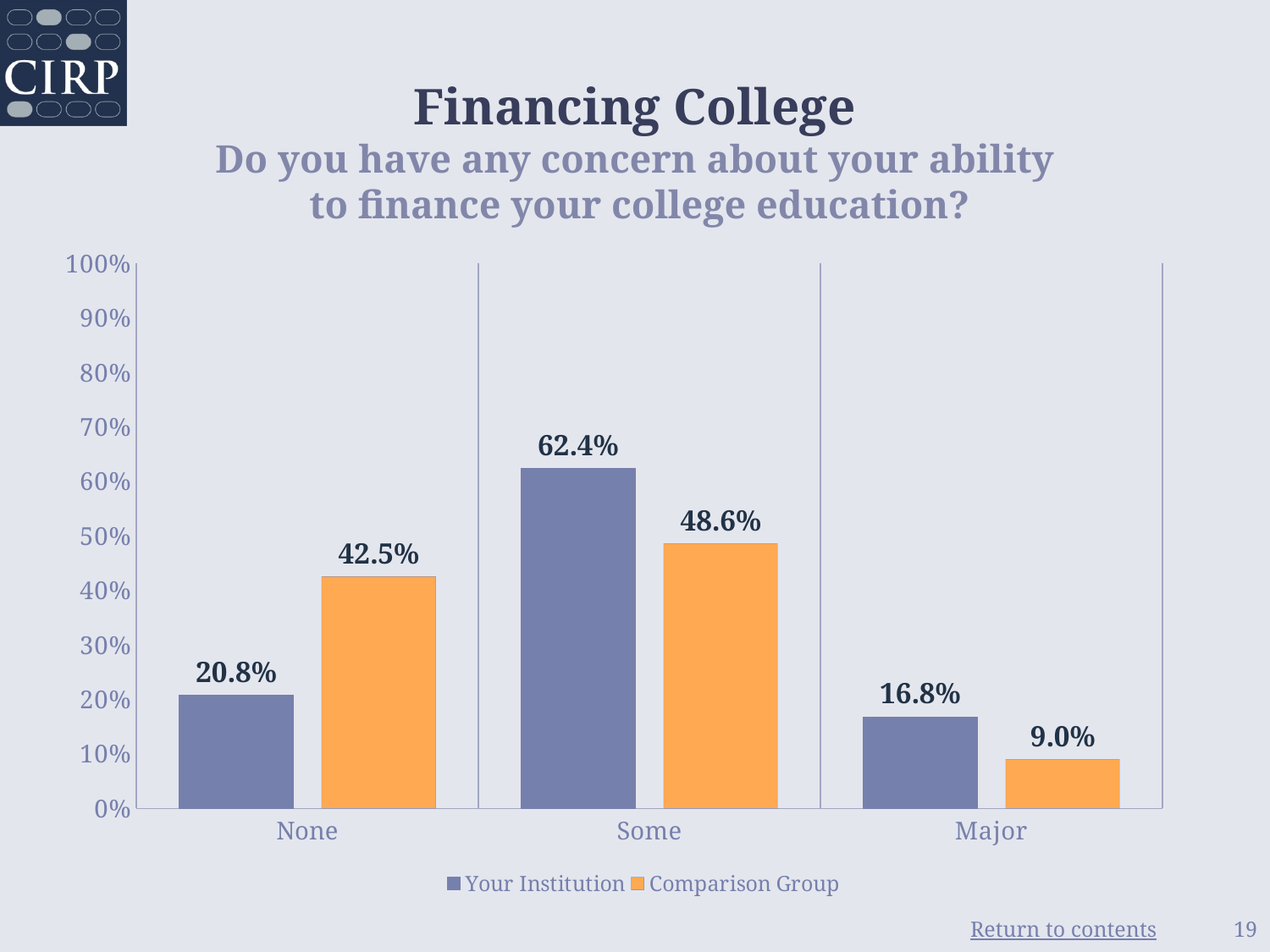
What type of chart is shown on the slide? Bar chart Which category has the highest value for Your Institution? Some How many series does the legend list? 2 In the 'Major' category, which series has the larger value, Your Institution or Comparison Group? Your Institution What is the difference between Your Institution and the Comparison Group in the 'None' category? 21.7% What is the difference between Your Institution and the Comparison Group in the 'Some' category? 13.8% Is the Your Institution value for 'None' greater or less than 30%? less What is the Comparison Group value for 'Major' concern? 9.0% What percentage of Your Institution respondents reported 'Some' concern about financing college? 62.4% What is the Comparison Group value for the 'None' category? 42.5% How many categories are shown on the x axis? 3 Which category has the lowest value for the Comparison Group? Major